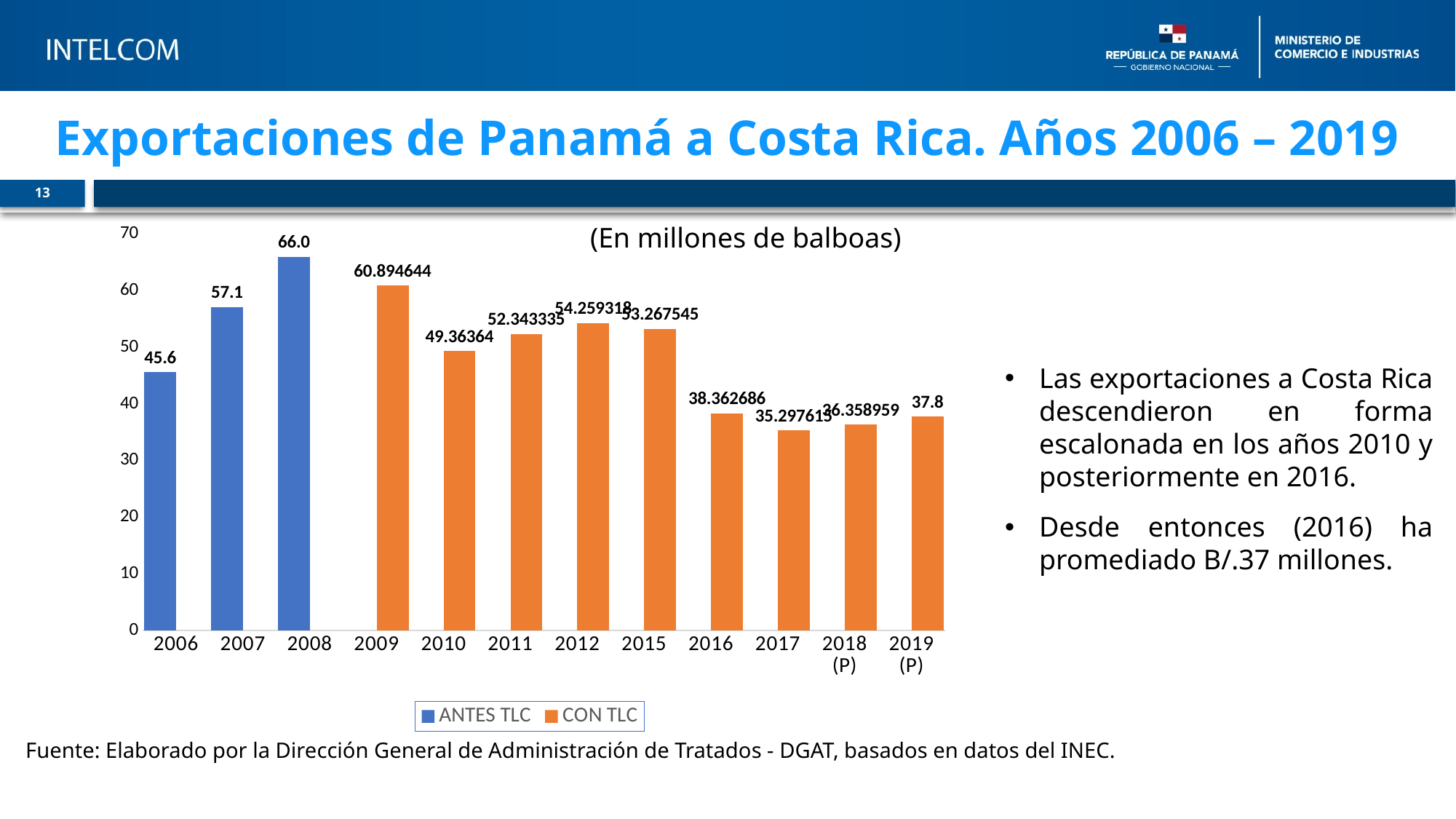
Do the ANTES TLC values rise or fall from 2006 to 2008? rise Is the value for 2016 greater or less than 40? less How many series does the legend list? 2 What is the value for 2019 (P) in the chart? 37.8 Which year has the lowest value in the chart? 2017 What is the value for 2009 in the chart? 60.894644 How many years are shown on the x axis of the chart? 12 What kind of chart is shown on the slide? bar chart Which is larger, the value for 2011 or the value for 2016? 2011 What is the value for 2008 in the chart? 66.0 What is the difference between the values for 2008 and 2006? 20.4 Which year has the highest value in the chart? 2008